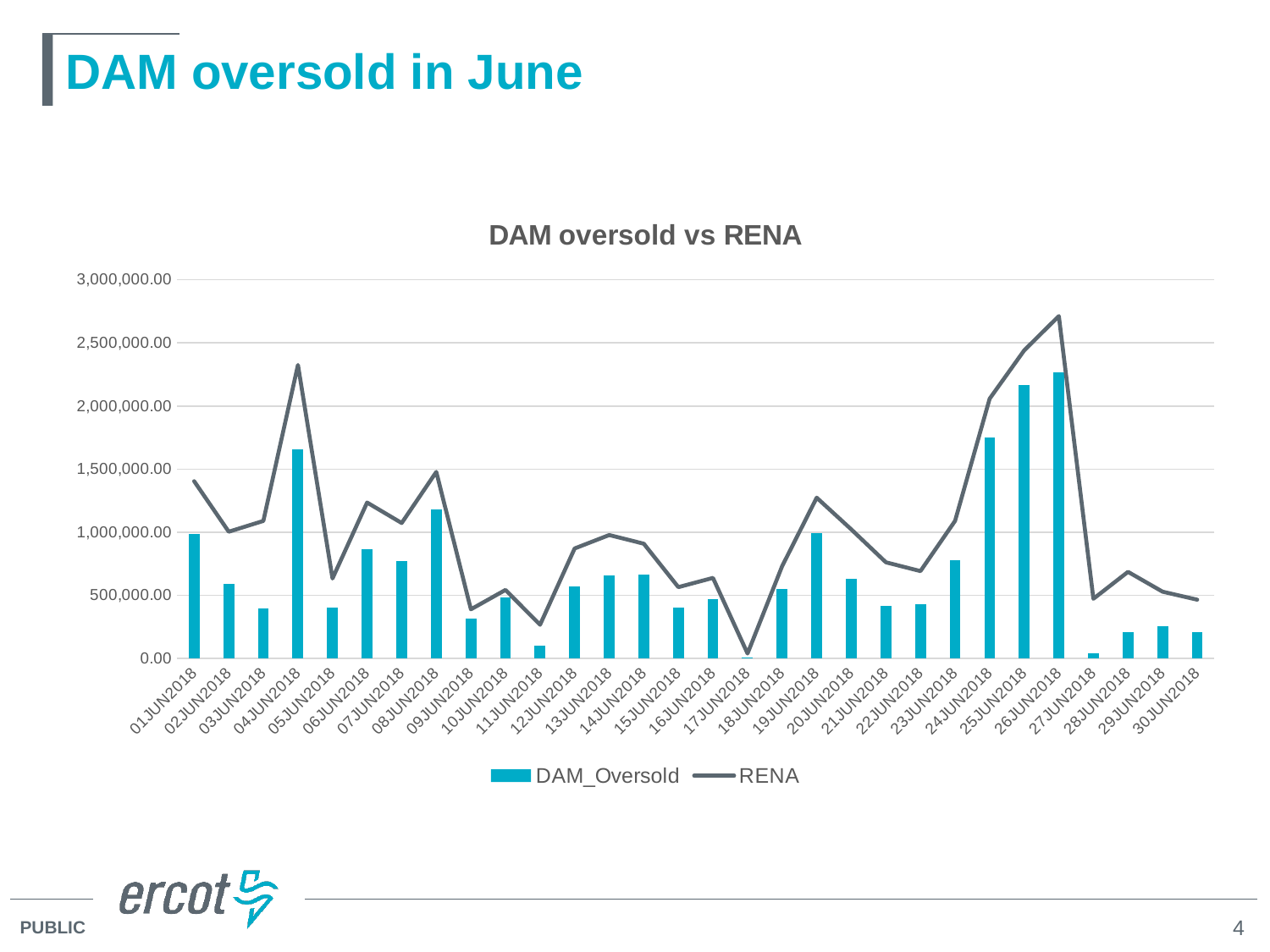
How many series does the chart legend list? 2 On which date is the DAM_Oversold bar the highest? 26JUN2018 Is the RENA value for 05JUN2018 greater or less than 2,000,000.00? less Is the DAM_Oversold value for 04JUN2018 greater or less than 1,500,000.00? greater What kind of chart is used to show the DAM_Oversold series? bar chart On which date does the RENA line reach its highest value? 26JUN2018 How many dates are shown on the x axis of the chart? 30 Which date has the larger DAM_Oversold value, 04JUN2018 or 05JUN2018? 04JUN2018 On which date is the DAM_Oversold bar the lowest? 17JUN2018 Which series is drawn as a line in the chart? RENA What is the title of the chart? DAM oversold vs RENA On which date does the RENA line reach its lowest value? 17JUN2018